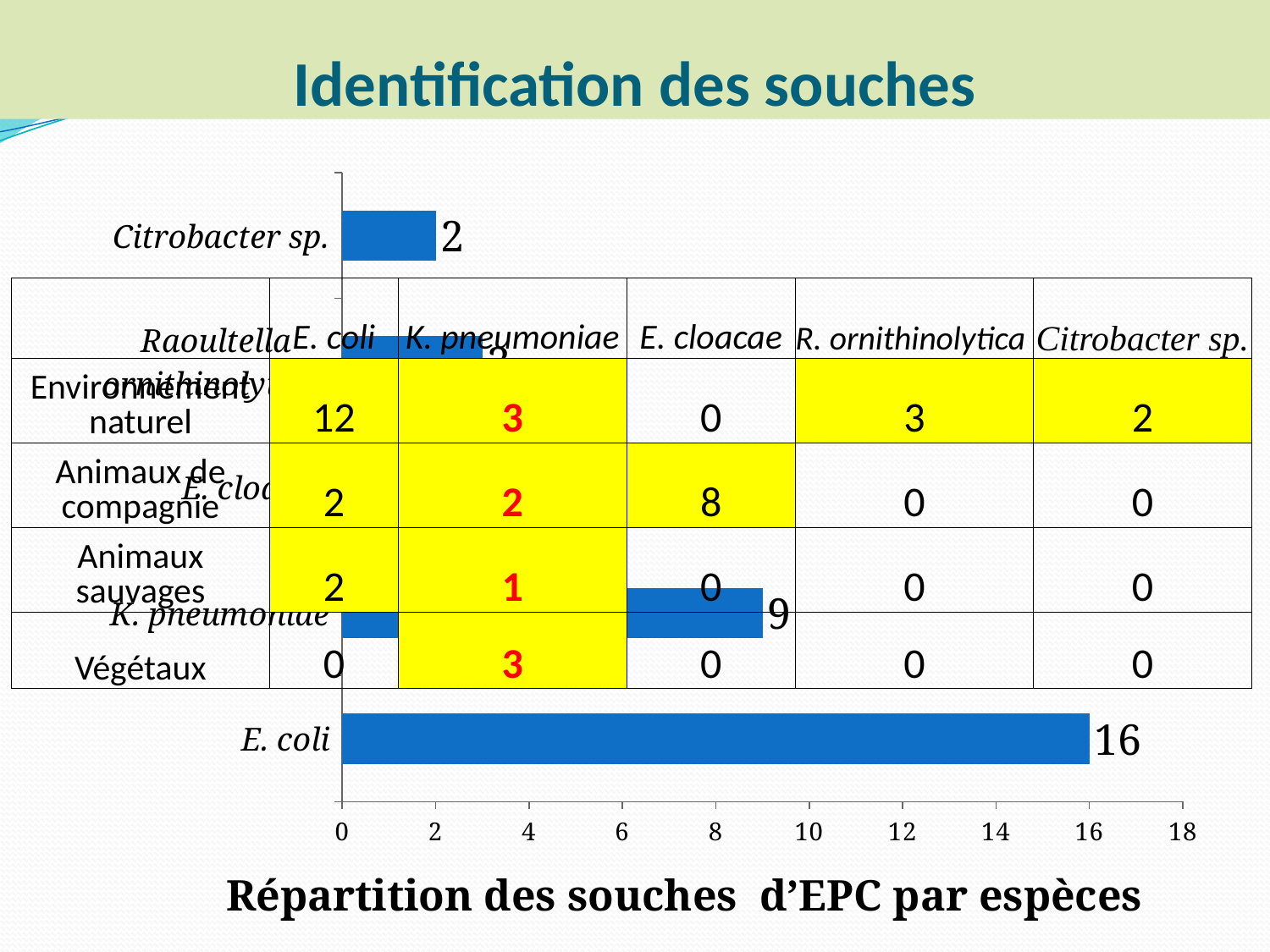
What is the value for E. coli in the chart? 16 What is the difference between the values for E. coli and Citrobacter sp.? 14 What is the highest value shown on the x axis of the chart? 18 Which is larger, the value for E. coli or the value for K. pneumoniae? E. coli What is the title of the chart? Répartition des souches d'EPC par espèces Is the value for Citrobacter sp. greater or less than 4? less What is the value for Citrobacter sp. in the chart? 2 What kind of chart is shown on the slide? bar chart What is the difference between the values for E. coli and K. pneumoniae? 7 Which species has the highest value in the chart? E. coli Is the value for E. coli greater or less than 10? greater What is the value for K. pneumoniae in the chart? 9